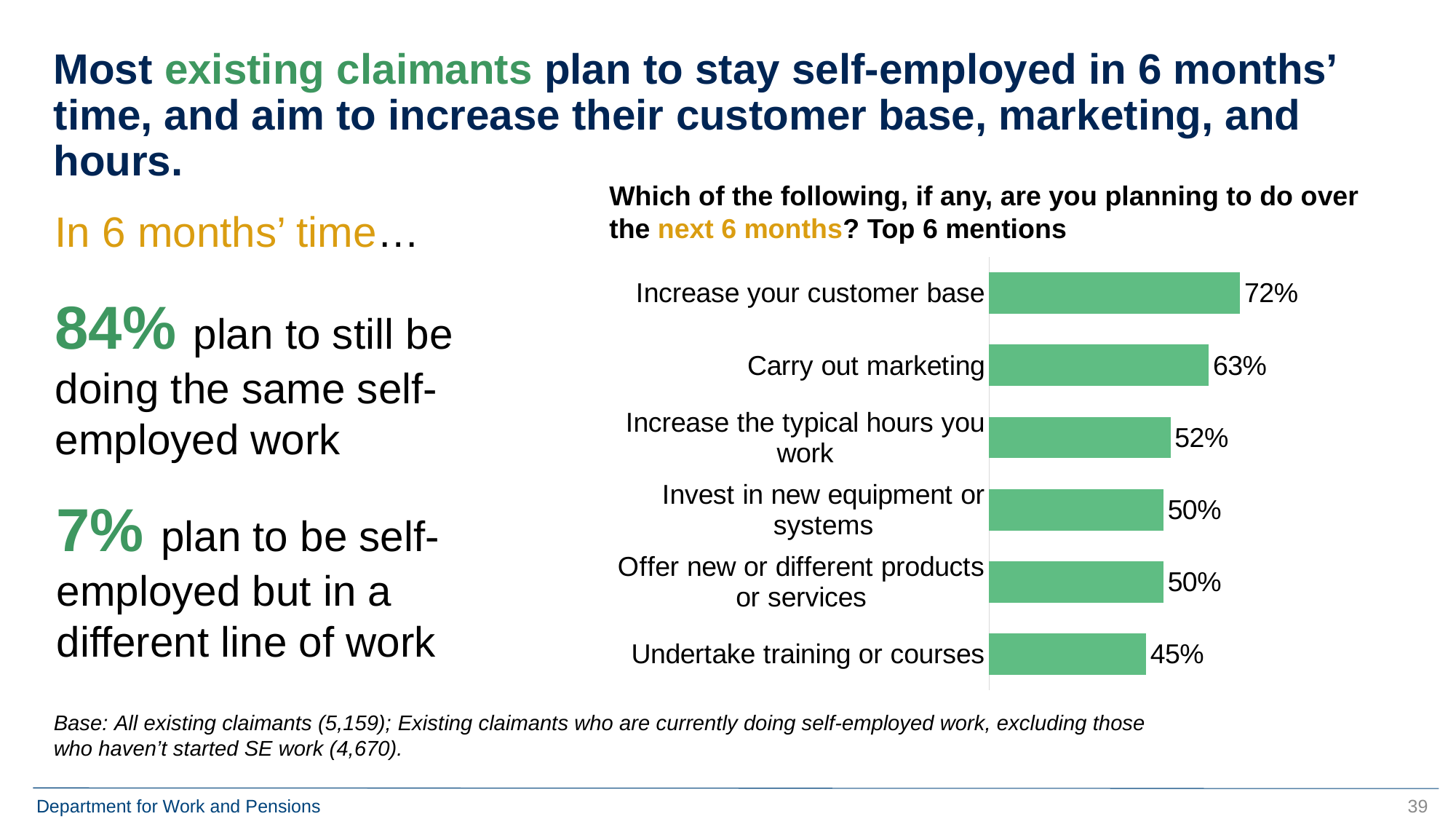
Which category has the highest value in the chart? Increase your customer base What is the value for 'Increase the typical hours you work'? 52% What kind of chart is shown on the slide? Bar chart What percentage plan to undertake training or courses? 45% How many categories are shown in the chart? 6 Which is larger: the value for 'Carry out marketing' or for 'Increase the typical hours you work'? Carry out marketing What is the value shown for 'Carry out marketing'? 63% Which two categories share the same value of 50%? Invest in new equipment or systems; Offer new or different products or services Which category has the lowest value in the chart? Undertake training or courses What is the difference between 'Carry out marketing' and 'Undertake training or courses'? 18% What is the difference between the values for 'Increase your customer base' and 'Carry out marketing'? 9% What percentage of existing claimants plan to increase their customer base over the next 6 months? 72%